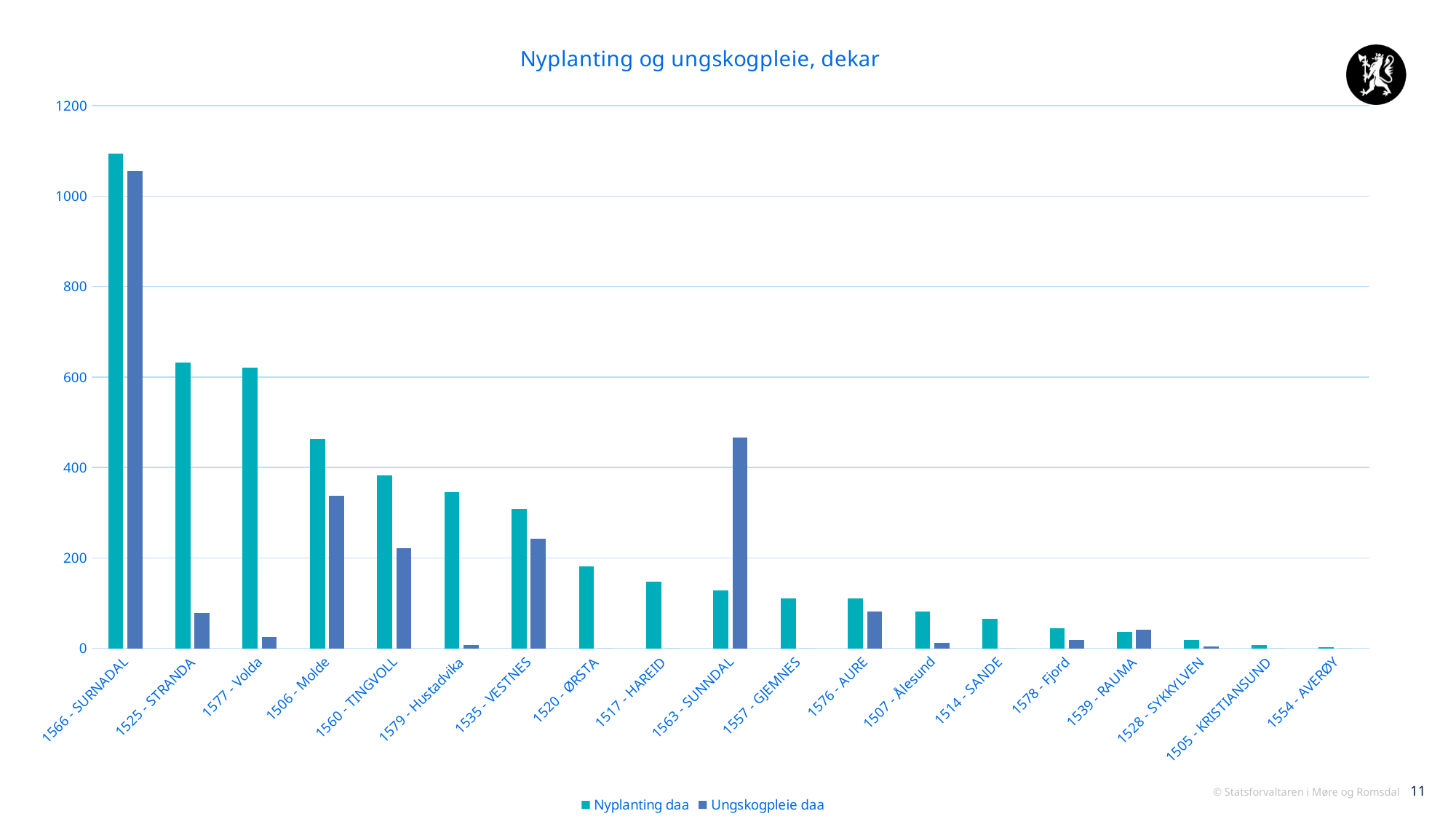
Is the Nyplanting daa value for 1566 - SURNADAL greater or less than 1000? greater How many municipalities (categories) are shown on the x axis? 19 Do the Nyplanting daa values generally rise or fall from left to right along the x axis? fall Which has the larger Nyplanting daa value: 1506 - Molde or 1560 - TINGVOLL? 1506 - Molde For 1563 - SUNNDAL, which is larger: Nyplanting daa or Ungskogpleie daa? Ungskogpleie daa Which municipality has the highest Ungskogpleie daa value? 1566 - SURNADAL How many series does the legend list? 2 Is the Ungskogpleie daa value for 1563 - SUNNDAL greater or less than 400? greater Is the Ungskogpleie daa value for 1506 - Molde greater or less than 400? less What kind of chart is shown on the slide? bar chart Which municipality has the highest Nyplanting daa value? 1566 - SURNADAL